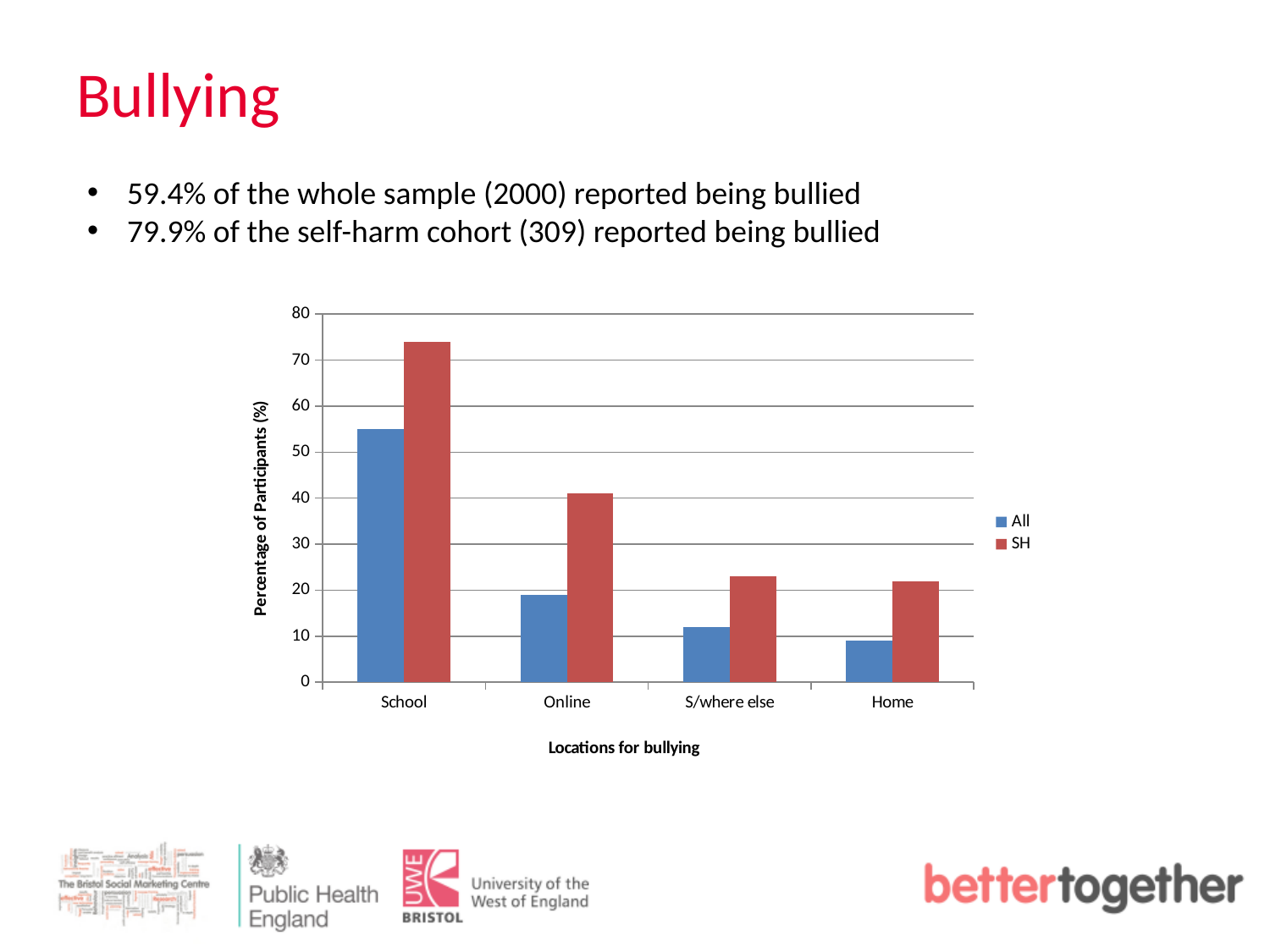
Is the value for Online in the SH series greater or less than 30? greater Do the values for the All series rise or fall from School to Home along the x axis? fall How many bullying locations are shown on the x axis? 4 What kind of chart is shown on the slide? bar chart Is the value for School in the All series greater or less than 50? greater What is the label of the y axis? Percentage of Participants (%) Which location has the lowest value for the All series? Home Which is larger for the All series: Online or S/where else? Online Is the value for Home in the SH series greater or less than 30? less How many series does the legend list? 2 Which location has the highest value for the SH series? School